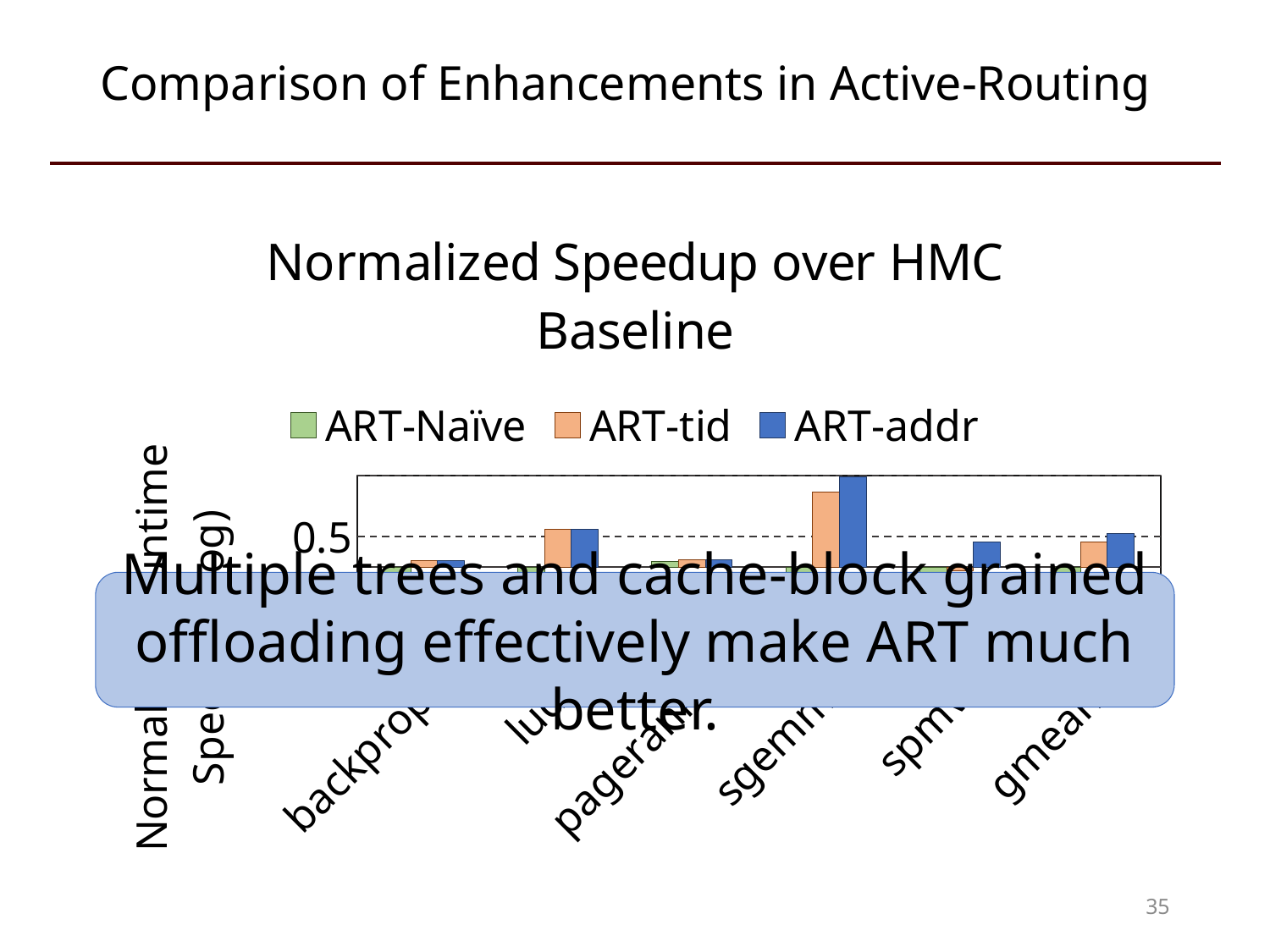
Which is larger, the ART-addr value for sgemm or the ART-addr value for backprop? sgemm Is the ART-addr value for spmv greater or less than 0.5? less What is the title of the chart? Normalized Speedup over HMC Baseline Which category has the highest ART-addr bar? sgemm Is the ART-tid value for backprop greater or less than 0.5? less How many series does the chart legend list? 3 Is the ART-tid value for sgemm greater or less than 0.5? greater Which series has the tallest bar for sgemm? ART-addr What kind of chart is shown on the slide? bar chart How many benchmark categories are shown on the x axis? 6 Which series are listed in the chart legend? ART-Naïve, ART-tid, ART-addr